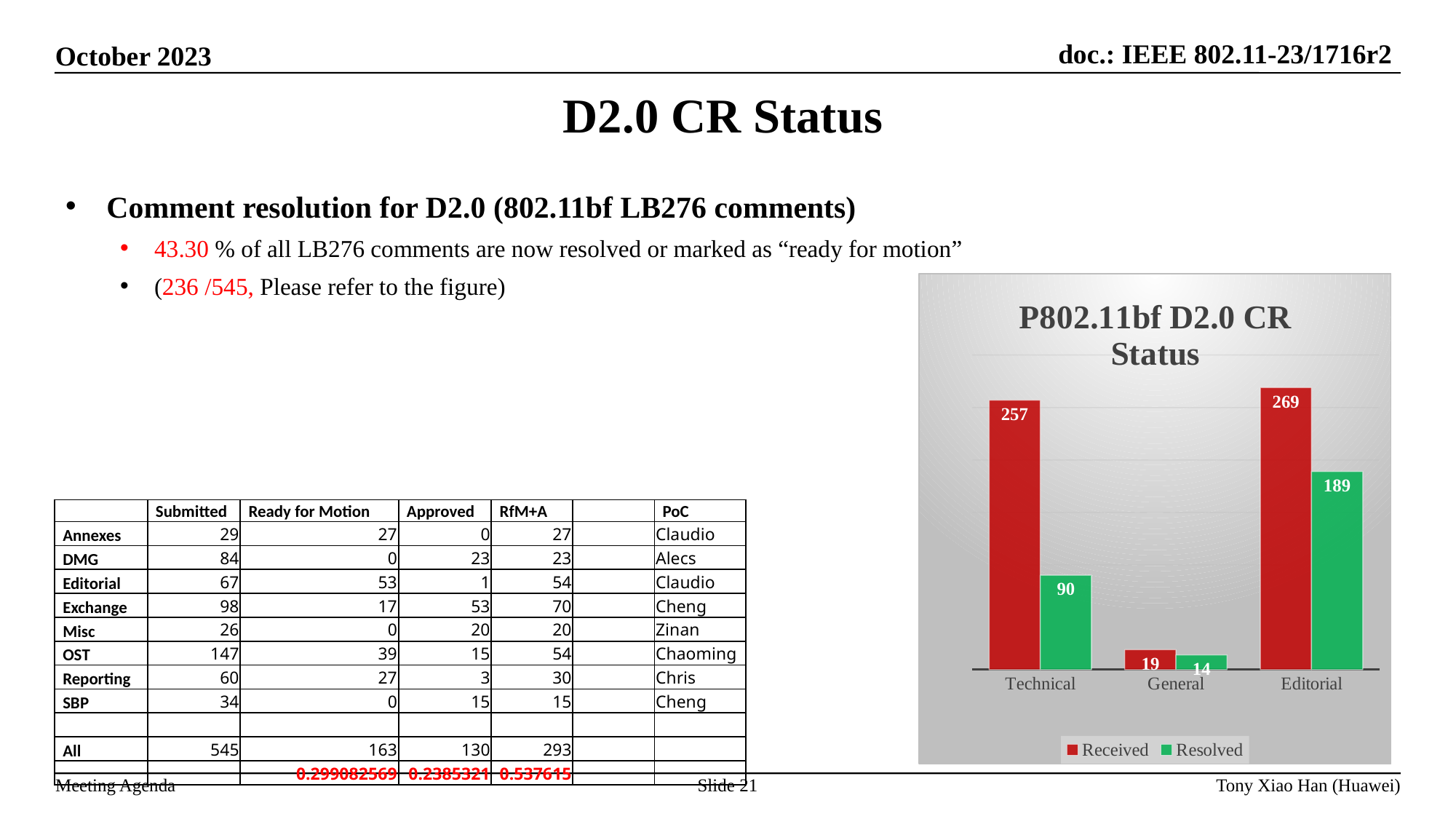
How many series does the chart legend list? 2 How many categories are shown on the x axis of the chart? 3 What type of chart is shown on the slide? bar chart What is the Received value for Technical? 257 What is the Resolved value for General? 14 Which colour represents the Resolved series in the chart? green What is the title of the chart? P802.11bf D2.0 CR Status What is the difference between Received and Resolved for Technical? 167 Which category has the highest Received value? Editorial Which category has the lowest Resolved value? General Which is larger, the Resolved value for Editorial or the Resolved value for Technical? Editorial What is the Resolved value for Editorial? 189